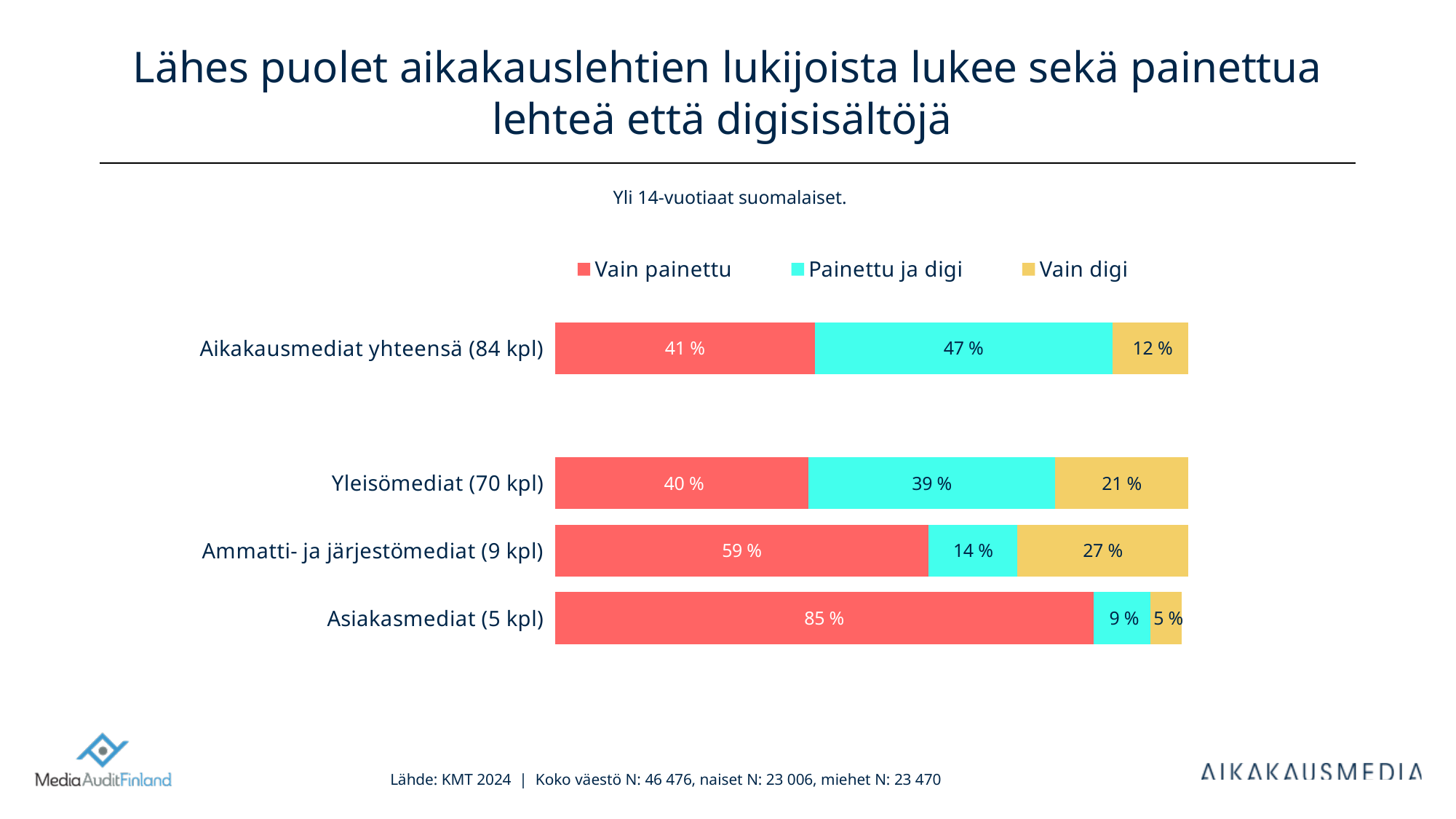
Which colour represents 'Painettu ja digi' in the legend? Cyan How many categories are shown in the chart? 4 What is the 'Painettu ja digi' value for Yleisömediat (70 kpl)? 39 % What is the 'Vain painettu' value for Asiakasmediat (5 kpl)? 85 % Which category has the lowest 'Vain digi' value? Asiakasmediat (5 kpl) What is the 'Painettu ja digi' value for Aikakausmediat yhteensä (84 kpl)? 47 % What is the difference between the 'Vain painettu' values for Ammatti- ja järjestömediat (9 kpl) and Yleisömediat (70 kpl)? 19 % What kind of chart is shown on the slide? Stacked bar chart How many series does the legend list? 3 Which category has the highest 'Vain painettu' value? Asiakasmediat (5 kpl) Which is larger: the 'Vain digi' value for Yleisömediat (70 kpl) or for Aikakausmediat yhteensä (84 kpl)? Yleisömediat (70 kpl) What is the 'Vain digi' value for Ammatti- ja järjestömediat (9 kpl)? 27 %